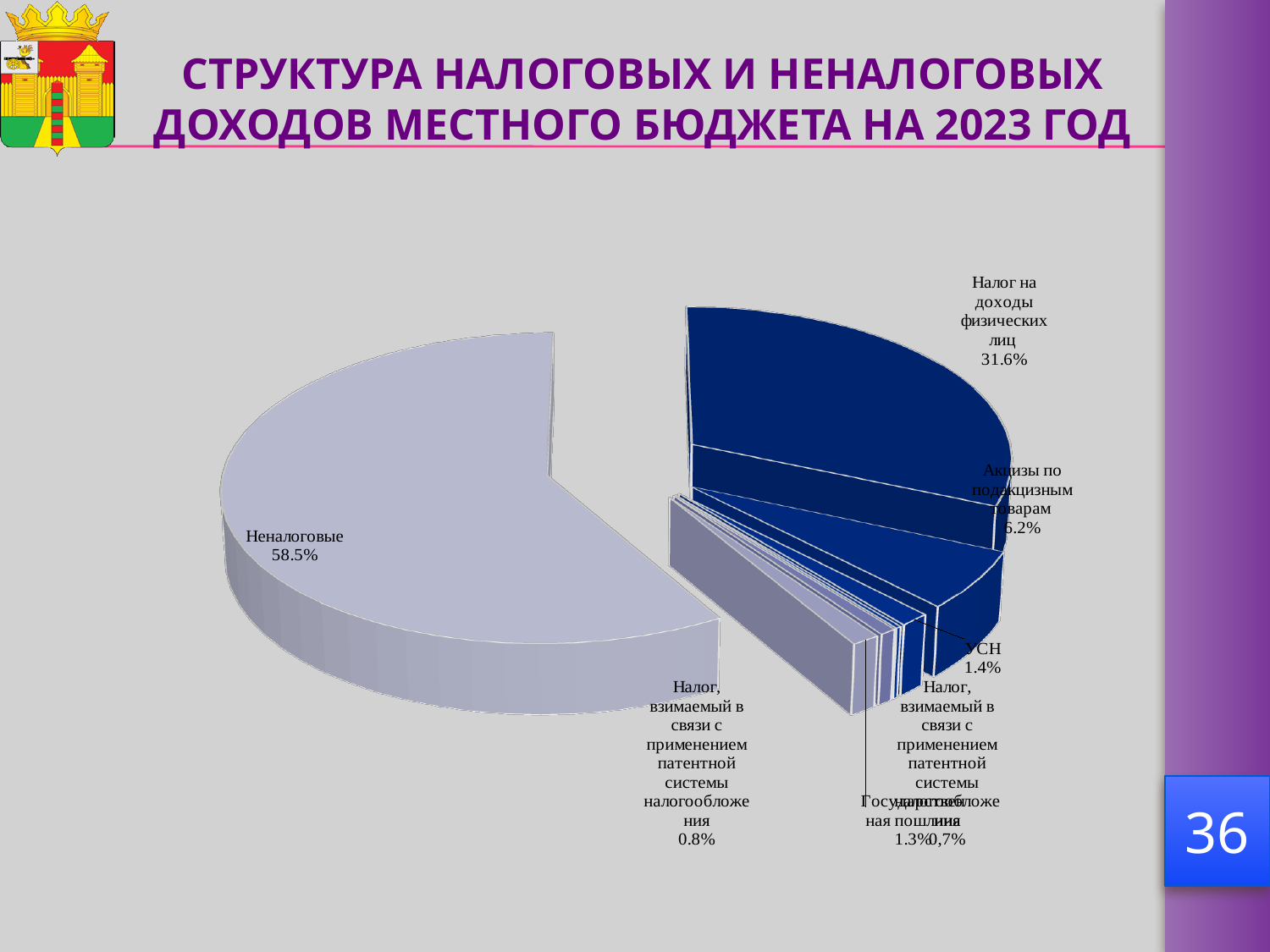
What share of the pie is labelled "Налог на доходы физических лиц"? 31.6% Which is larger: the share for "УСН" or the share for "Государственная пошлина"? УСН What is the difference in percentage points between the "Неналоговые" share and the "Налог на доходы физических лиц" share? 26.9 What share of the pie is labelled "Неналоговые"? 58.5% What share of the pie is labelled "УСН"? 1.4% Which is larger: the share for "Налог на доходы физических лиц" or the share for "Акцизы по подакцизным товарам"? Налог на доходы физических лиц Which slice of the pie is the largest? Неналоговые What is the difference in percentage points between the "Акцизы по подакцизным товарам" share and the "УСН" share? 4.8 What share of the pie is labelled "Государственная пошлина"? 1.3% What share of the pie is labelled "Акцизы по подакцизным товарам"? 6.2% What kind of chart is shown on the slide? pie chart What is the title of the slide containing the chart? СТРУКТУРА НАЛОГОВЫХ И НЕНАЛОГОВЫХ ДОХОДОВ МЕСТНОГО БЮДЖЕТА НА 2023 ГОД